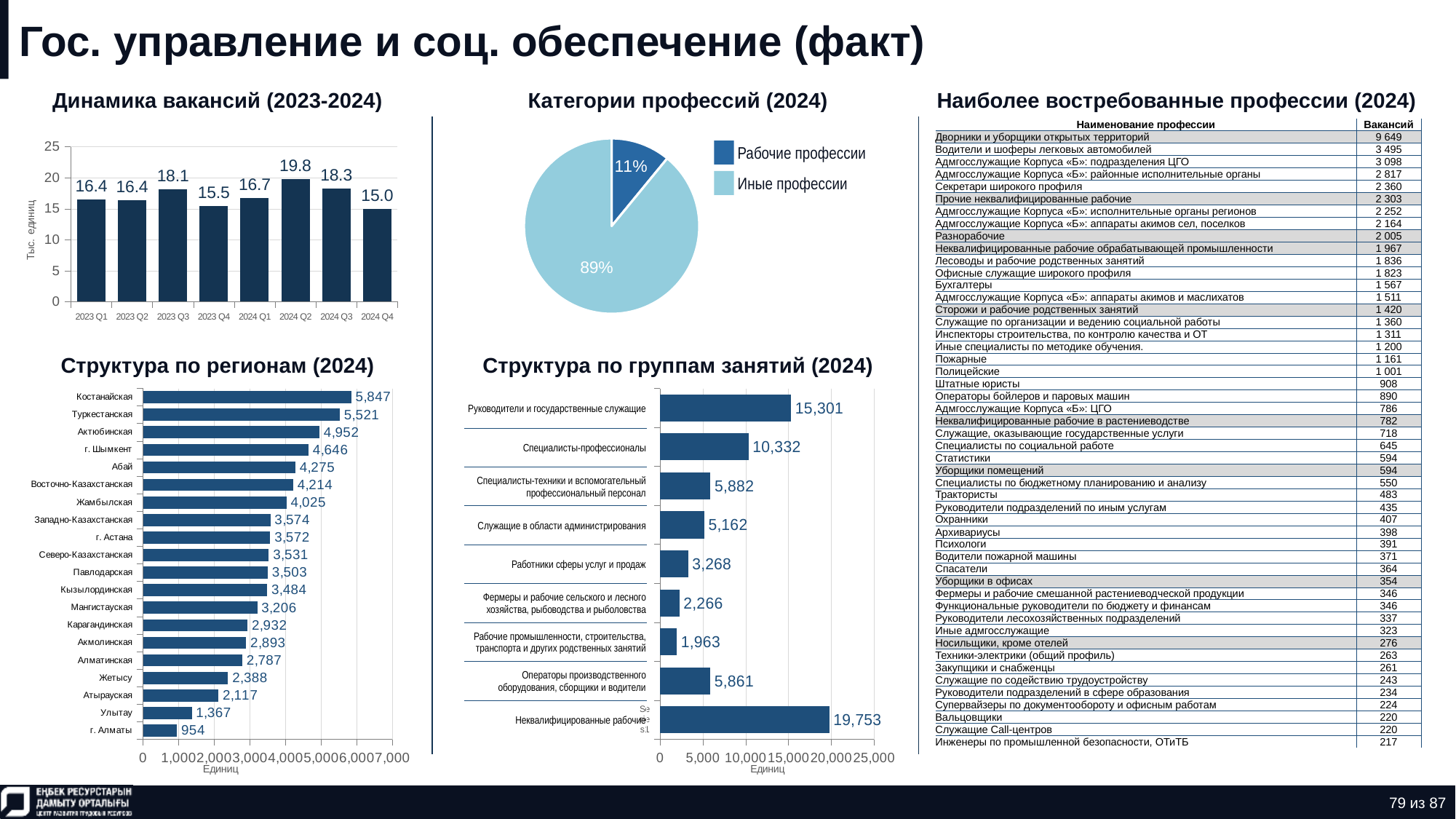
What type of chart is 'Структура по группам занятий (2024)'? Bar chart In the chart 'Структура по регионам (2024)', which region has the highest value? Костанайская In the chart 'Динамика вакансий (2023-2024)', which quarter has the lowest value? 2024 Q4 In the pie chart 'Категории профессий (2024)', how many entries does the legend list? 2 In the chart 'Динамика вакансий (2023-2024)', what is the difference between the values for 2024 Q2 and 2024 Q4? 4.8 In the chart 'Структура по регионам (2024)', how many regions are shown? 20 In the pie chart 'Категории профессий (2024)', what share do 'Рабочие профессии' have? 11% In the chart 'Структура по регионам (2024)', what is the value for Карагандинская? 2,932 In the chart 'Динамика вакансий (2023-2024)', how many quarters are plotted? 8 In the chart 'Структура по группам занятий (2024)', which group has the highest value? Неквалифицированные рабочие In the chart 'Структура по группам занятий (2024)', which is larger: 'Специалисты-профессионалы' or 'Операторы производственного оборудования, сборщики и водители'? Специалисты-профессионалы In the chart 'Динамика вакансий (2023-2024)', what is the value for 2024 Q2? 19.8